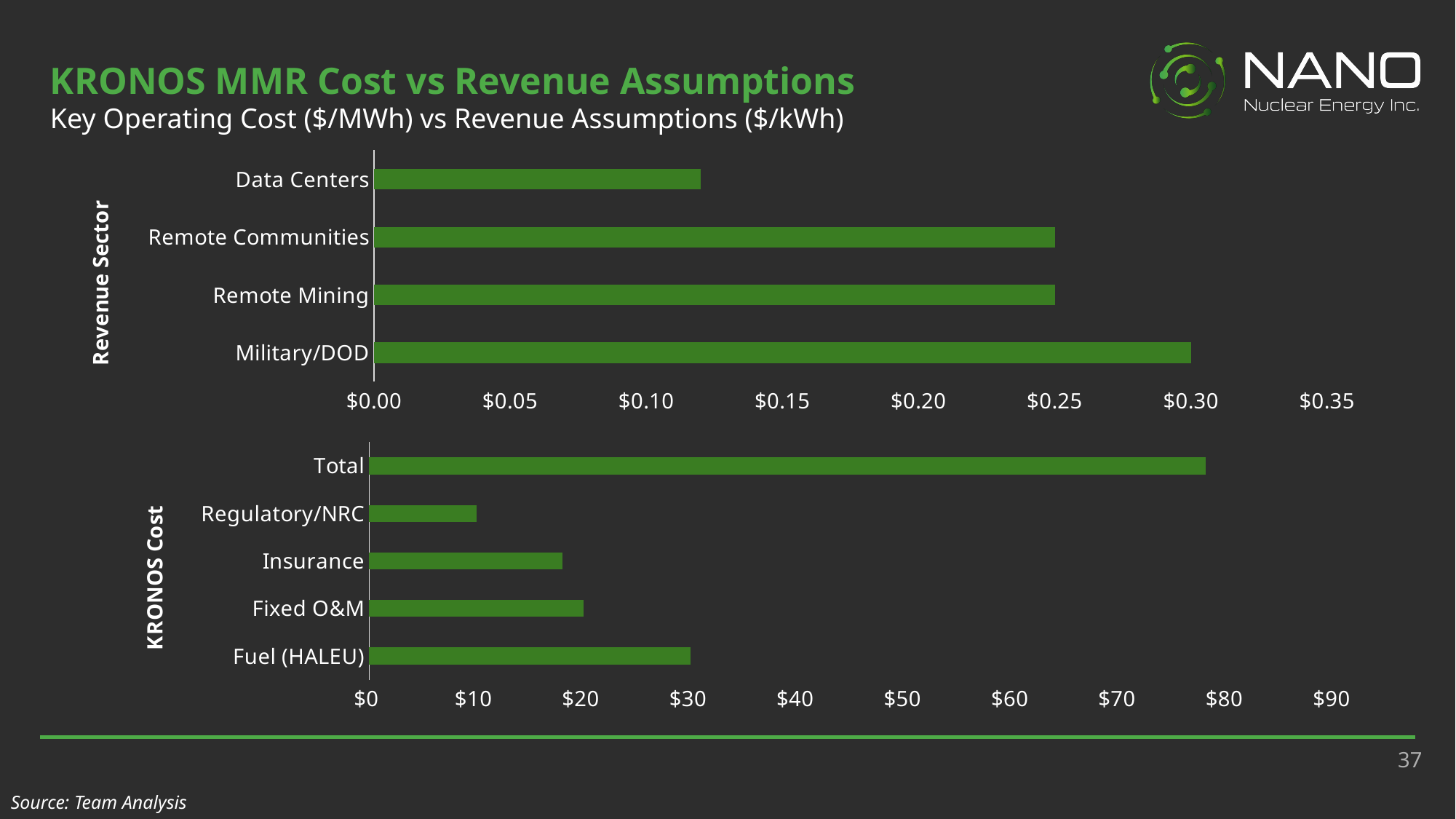
In the Revenue Sector chart, how many revenue sectors are shown? 4 What type of chart is the Revenue Sector chart at the top of the slide? bar chart In the Revenue Sector chart, what is the value for Remote Communities? $0.25 In the KRONOS Cost chart, which cost category has the lowest value? Regulatory/NRC In the KRONOS Cost chart, which is larger, Fuel (HALEU) or Insurance? Fuel (HALEU) In the Revenue Sector chart, what is the value for Military/DOD? $0.30 In the KRONOS Cost chart, which cost category has the highest value? Total In the Revenue Sector chart, which revenue sector has the highest value? Military/DOD In the Revenue Sector chart, is the value for Data Centers greater or less than $0.10? greater In the Revenue Sector chart, which revenue sector has the lowest value? Data Centers In the KRONOS Cost chart, how many cost categories are shown? 5 In the KRONOS Cost chart, is the value for Total greater or less than $70? greater